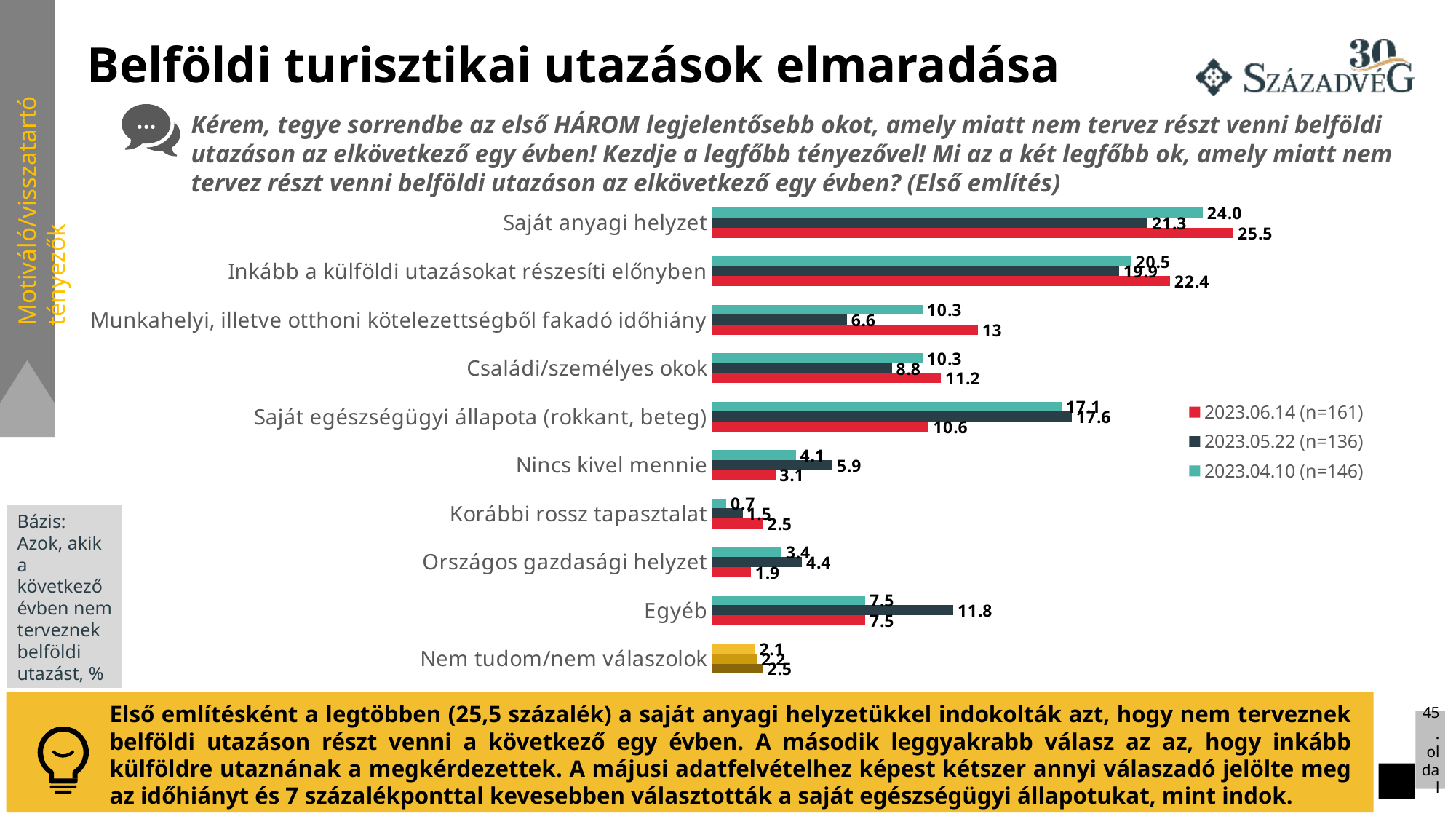
Which colour represents the 2023.06.14 (n=161) series in the legend? Red What is the value for "Saját egészségügyi állapota (rokkant, beteg)" in the 2023.04.10 (n=146) series? 17.1 What kind of chart is shown on the slide? Bar chart Which category has the highest value in the 2023.06.14 (n=161) series? Saját anyagi helyzet What is the difference between the 2023.06.14 (n=161) and 2023.05.22 (n=136) values for "Munkahelyi, illetve otthoni kötelezettségből fakadó időhiány"? 6.4 How many series does the legend list? 3 What is the value for "Nincs kivel mennie" in the 2023.05.22 (n=136) series? 5.9 Which category has the lowest value in the 2023.04.10 (n=146) series? Korábbi rossz tapasztalat How many categories are shown on the chart? 10 What is the value for "Saját anyagi helyzet" in the 2023.06.14 (n=161) series? 25.5 For "Saját egészségügyi állapota (rokkant, beteg)", which series has the larger value: 2023.06.14 (n=161) or 2023.05.22 (n=136)? 2023.05.22 (n=136) What is the value for "Egyéb" in the 2023.05.22 (n=136) series? 11.8